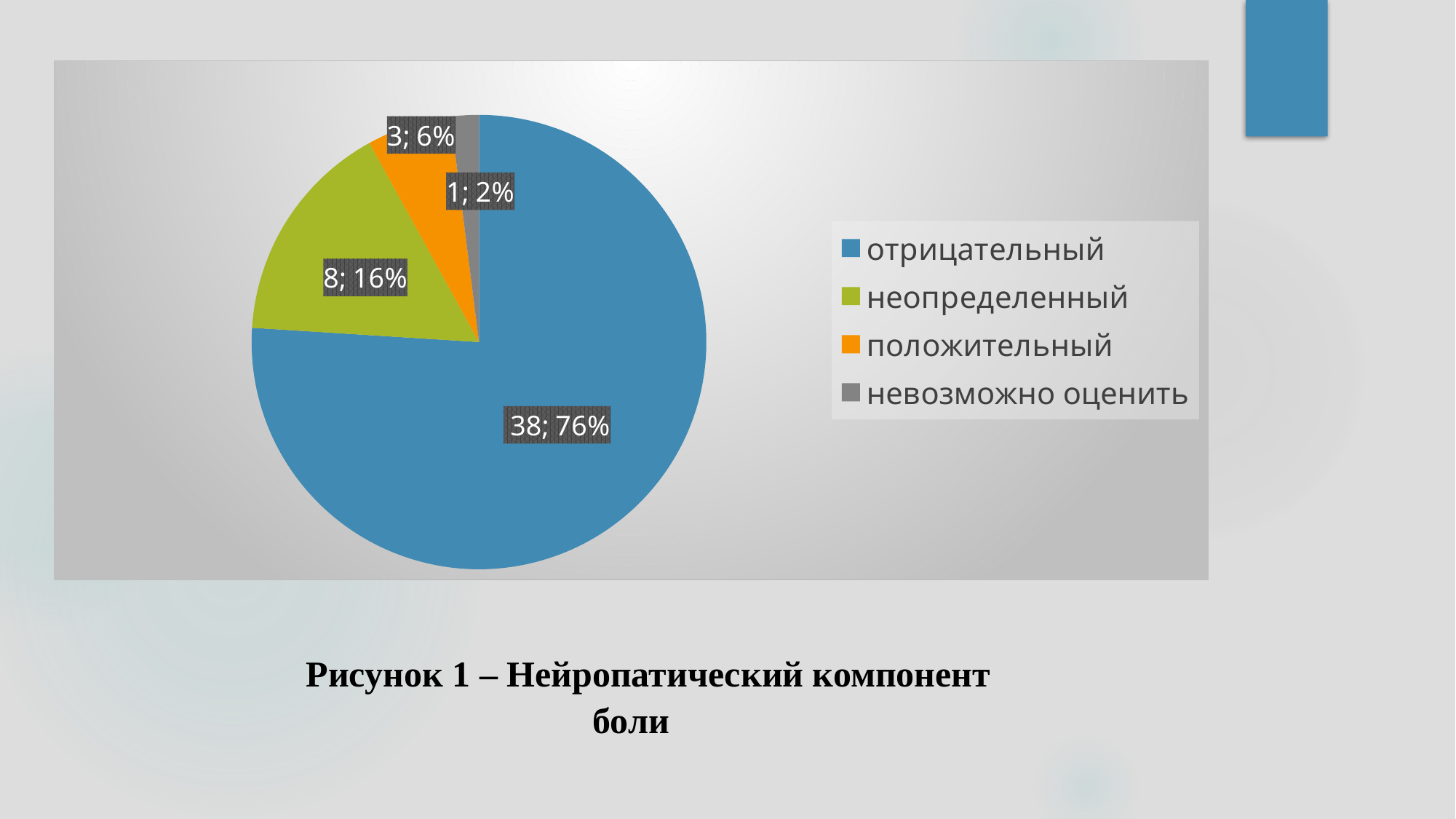
How many categories does the pie chart have? 4 How many patients fall into the 'отрицательный' category? 38 Which is larger, the 'положительный' slice or the 'неопределенный' slice? неопределенный Which category has the largest slice of the pie? отрицательный What is the count for the 'положительный' category? 3 What is the total count across all slices of the pie? 50 What kind of chart is shown on the slide? Pie chart What is the difference in count between 'отрицательный' and 'неопределенный'? 30 What colour is the 'положительный' slice? Orange What percentage share does the 'невозможно оценить' slice have? 2% What percentage share does the 'неопределенный' slice have? 16% Which category has the smallest slice of the pie? невозможно оценить